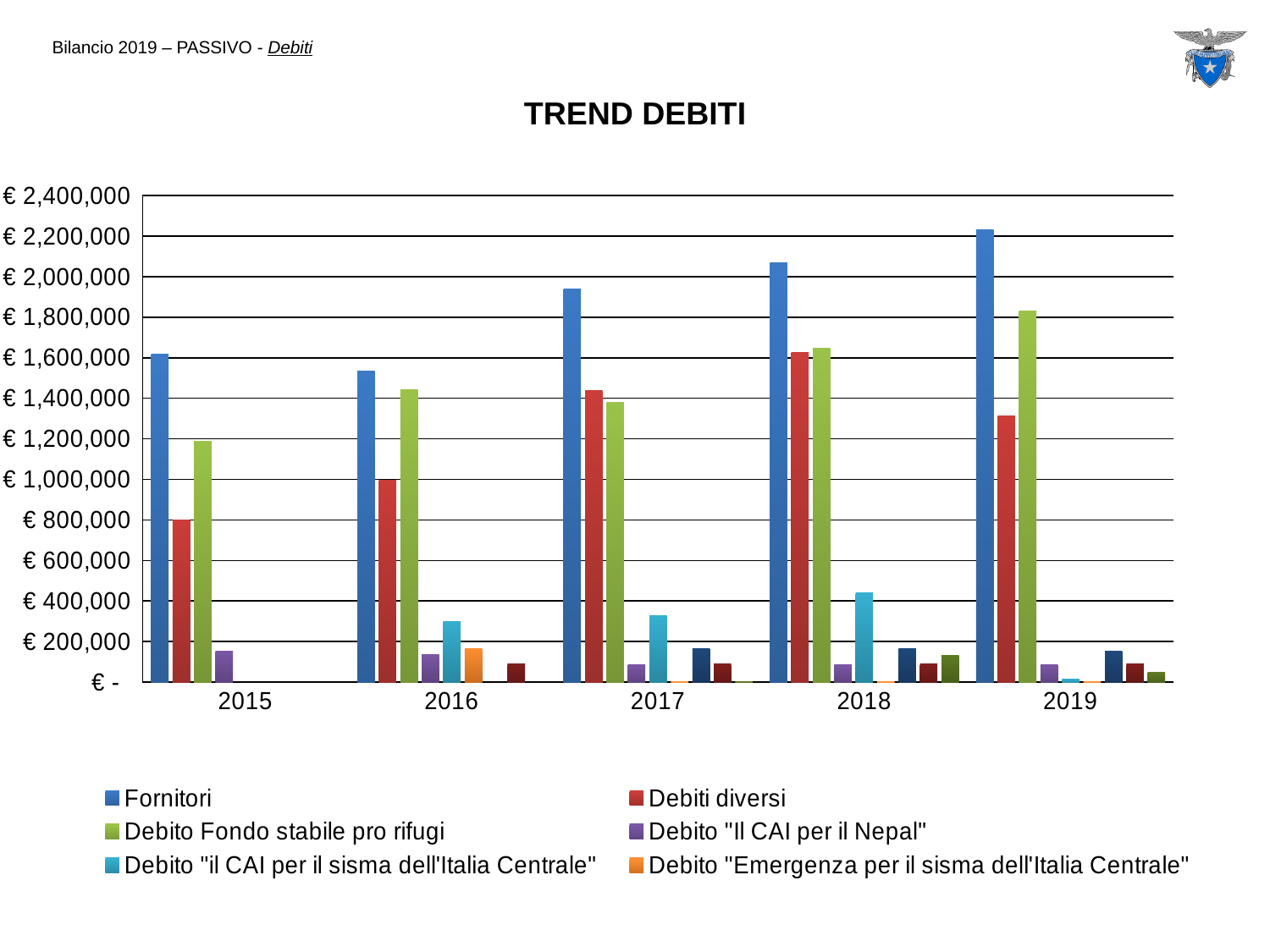
Is the value of Debito "il CAI per il sisma dell'Italia Centrale" for 2018 greater or less than € 400,000? greater In which year is the Debiti diversi value highest? 2018 Does the Fornitori value rise or fall from 2017 to 2019? rise How many years are shown on the x axis of the chart? 5 How many series does the chart's legend list? 6 What is the title of the chart? TREND DEBITI Is the Fornitori value for 2019 greater or less than € 2,000,000? greater In which year is the Fornitori value highest? 2019 Is the value of Debito "Il CAI per il Nepal" for 2015 greater or less than € 200,000? less What kind of chart is shown on the slide? bar chart In 2019, which is larger: Debito Fondo stabile pro rifugi or Debiti diversi? Debito Fondo stabile pro rifugi In which year is the Debito Fondo stabile pro rifugi value lowest? 2015